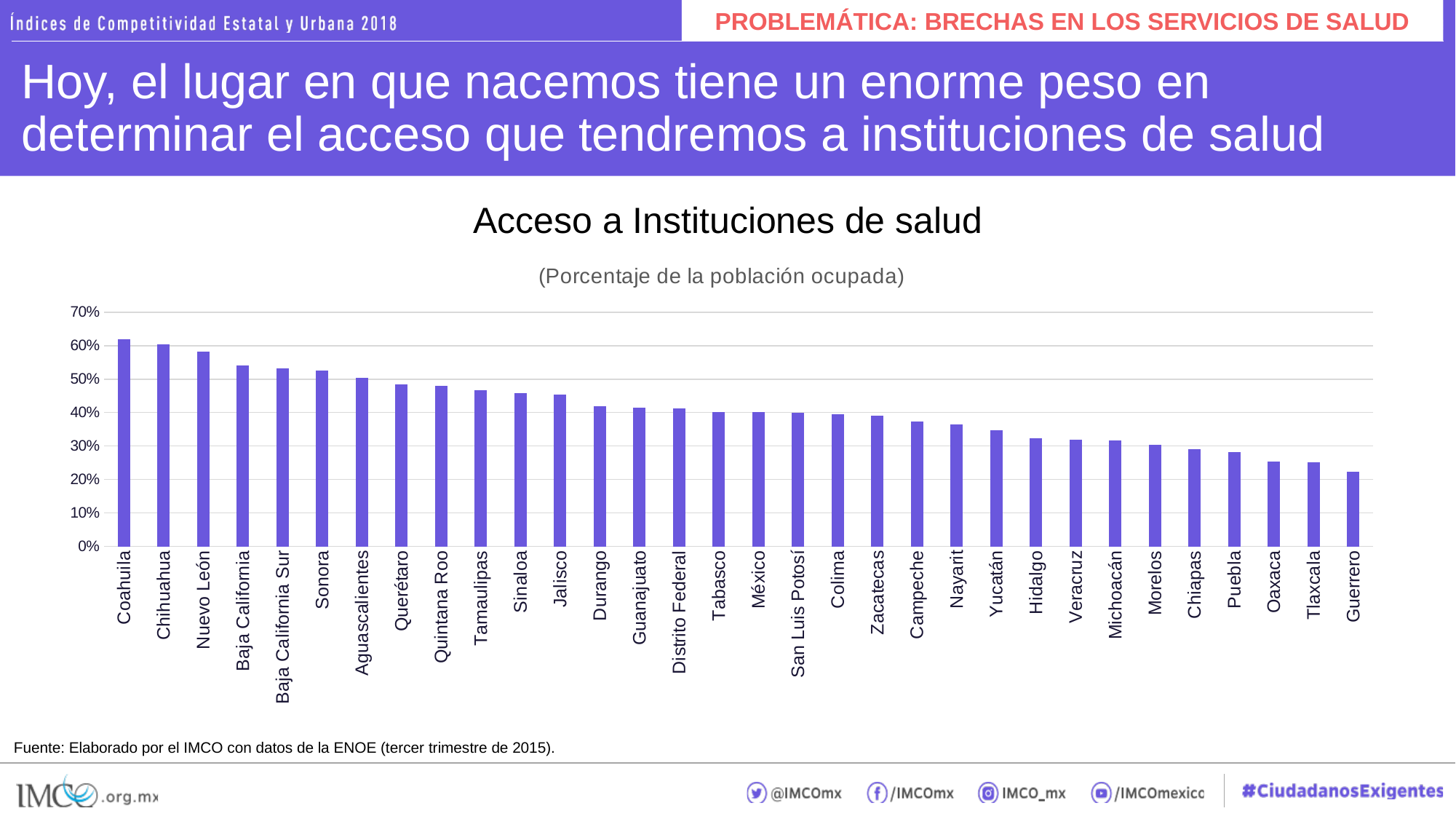
Do the values rise or fall moving from left to right along the x axis? fall Is the value for Coahuila greater or less than 60%? greater Is the value for Sonora greater or less than 50%? greater What is the title of the chart? Acceso a Instituciones de salud Is the value for Nayarit greater or less than 40%? less Which has a larger value, Baja California or Puebla? Baja California What kind of chart is shown on the slide? bar chart Which state has the highest value in the chart? Coahuila Which state has the lowest value in the chart? Guerrero How many states are shown in the chart? 32